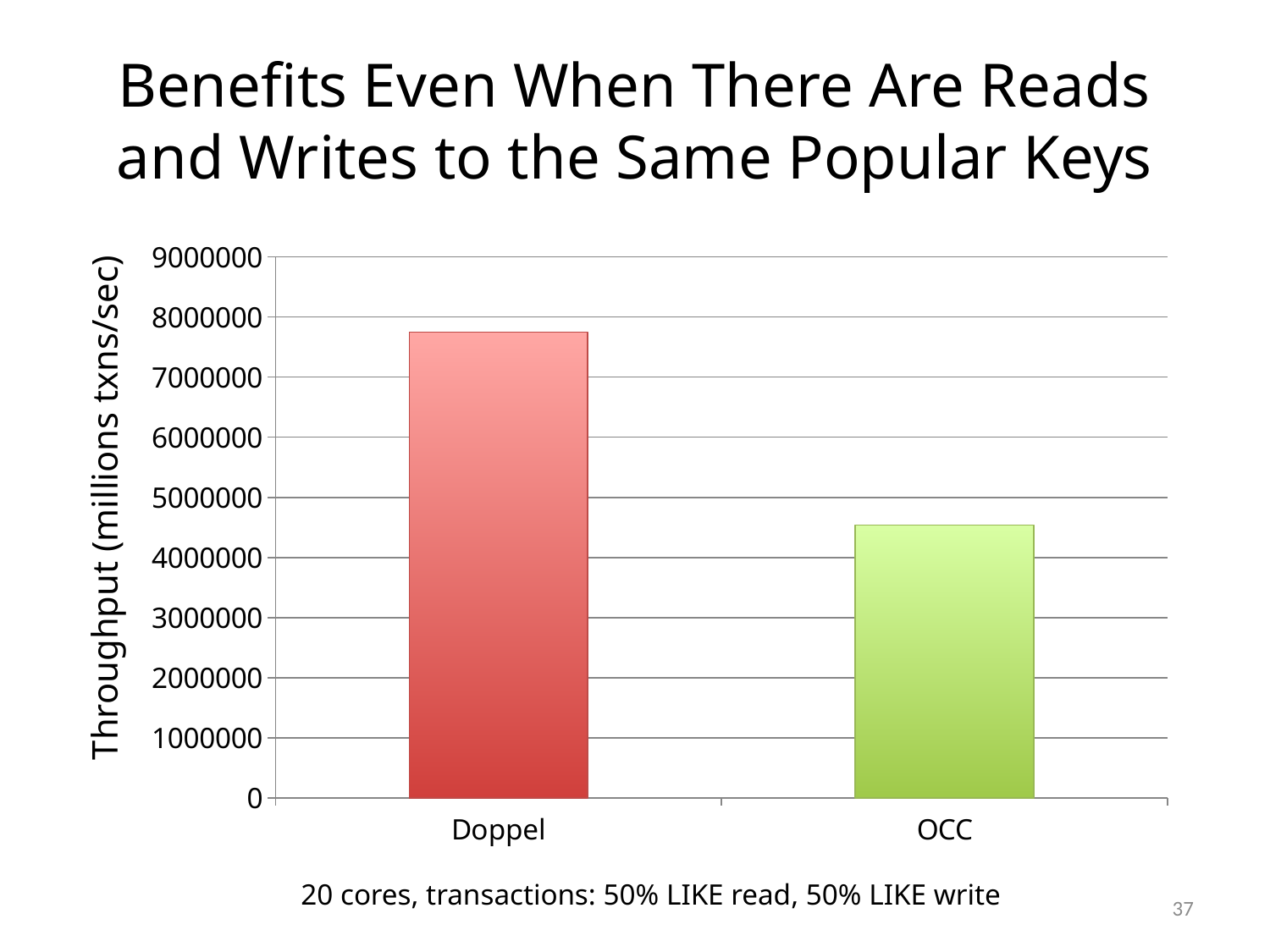
Which has a larger throughput, Doppel or OCC? Doppel What kind of chart is shown on the slide? bar chart Which category has the highest throughput? Doppel Is the throughput for Doppel greater or less than 7000000? greater Is the throughput for OCC greater or less than 4000000? greater Is the throughput for OCC greater or less than 5000000? less What is the label of the y axis? Throughput (millions txns/sec) Which category has the lowest throughput? OCC What is the maximum value shown on the y axis? 9000000 How many categories are plotted on the x axis? 2